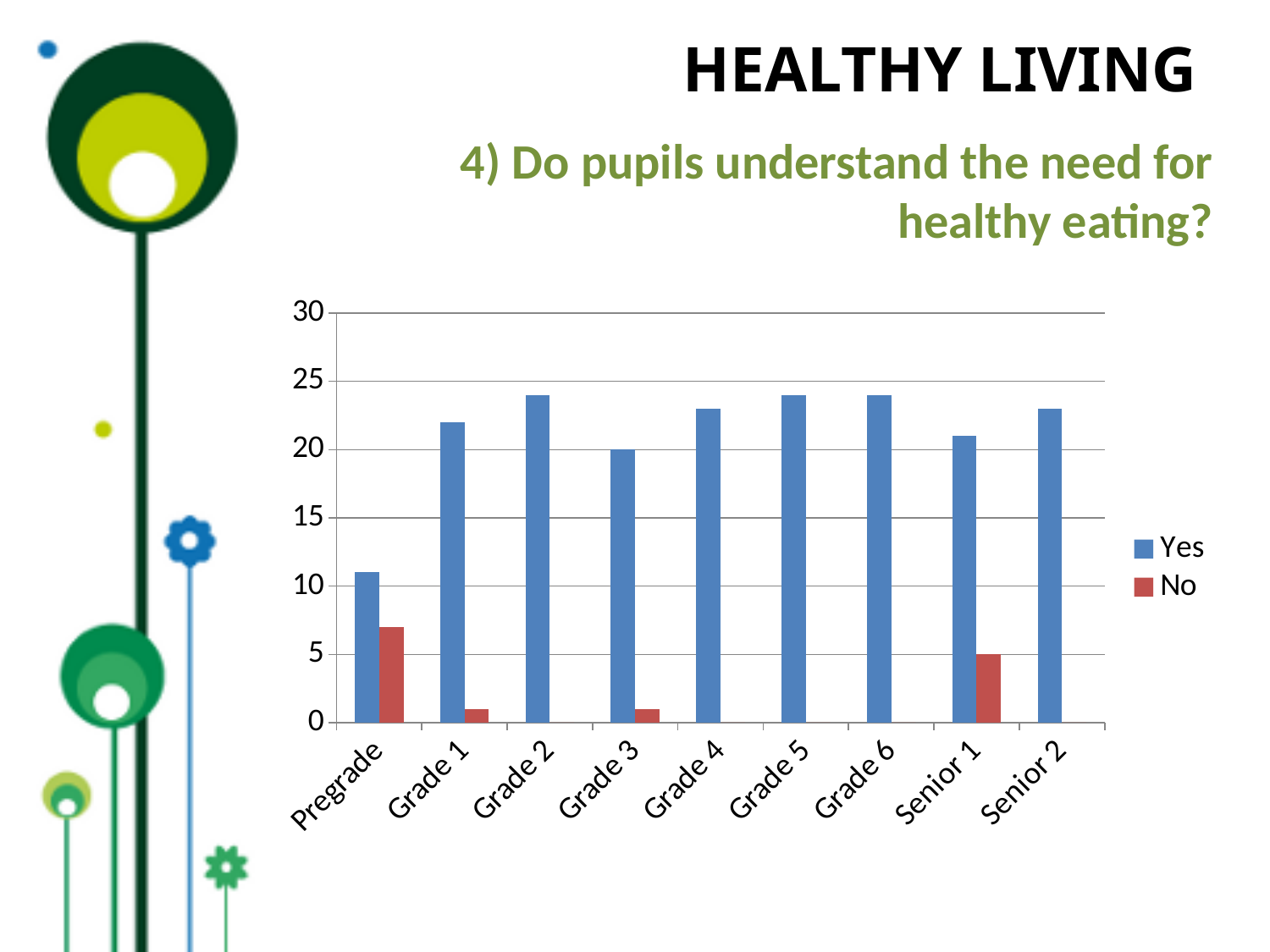
What is the value for Yes in Grade 3? 20 Which category has the highest value for the No series? Pregrade Which is larger, the No value for Senior 1 or the No value for Grade 1? Senior 1 Is the value for Yes in Grade 1 greater or less than 20? greater How many series does the legend list? 2 What is the value for No in Senior 1? 5 Which category has the lowest value for the Yes series? Pregrade Is the value for Yes in Pregrade greater or less than 15? less In Pregrade, which is larger, the Yes value or the No value? Yes What kind of chart is shown on the slide? bar chart How many grade categories are shown on the x axis? 9 What colour represents the No series in the legend? red